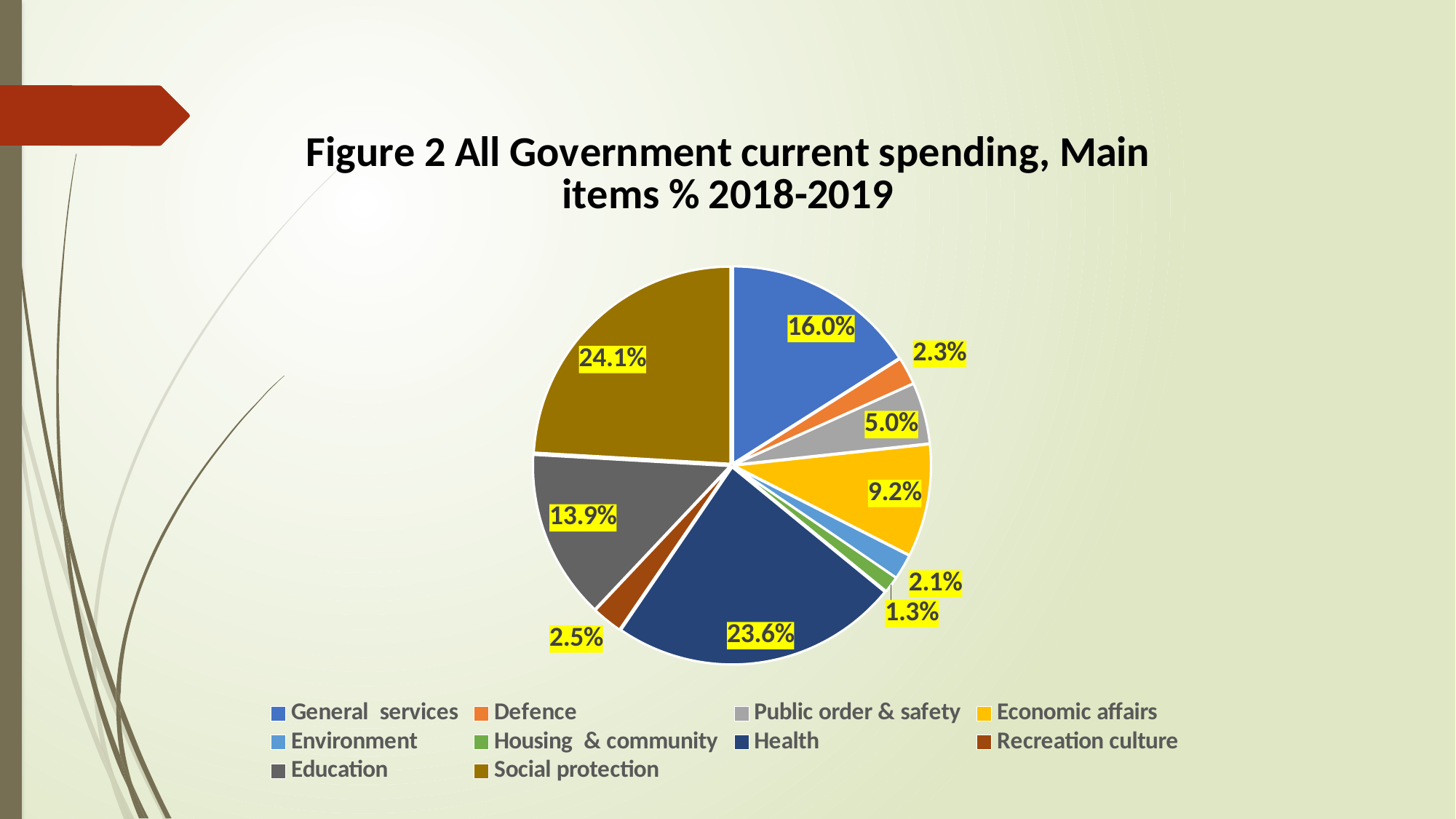
How many categories does the legend list? 10 What is the share for Defence? 2.3% Which category has the largest share of the pie? Social protection Which category has the smallest share of the pie? Housing & community What is the share for Health? 23.6% What is the share for Education? 13.9% What is the difference between the shares for Social protection and Health? 0.5% What kind of chart is shown on the slide? pie chart What is the title of the chart? Figure 2 All Government current spending, Main items % 2018-2019 What is the share for Economic affairs? 9.2% What is the share for Social protection? 24.1% Which is larger, the share for General services or the share for Education? General services